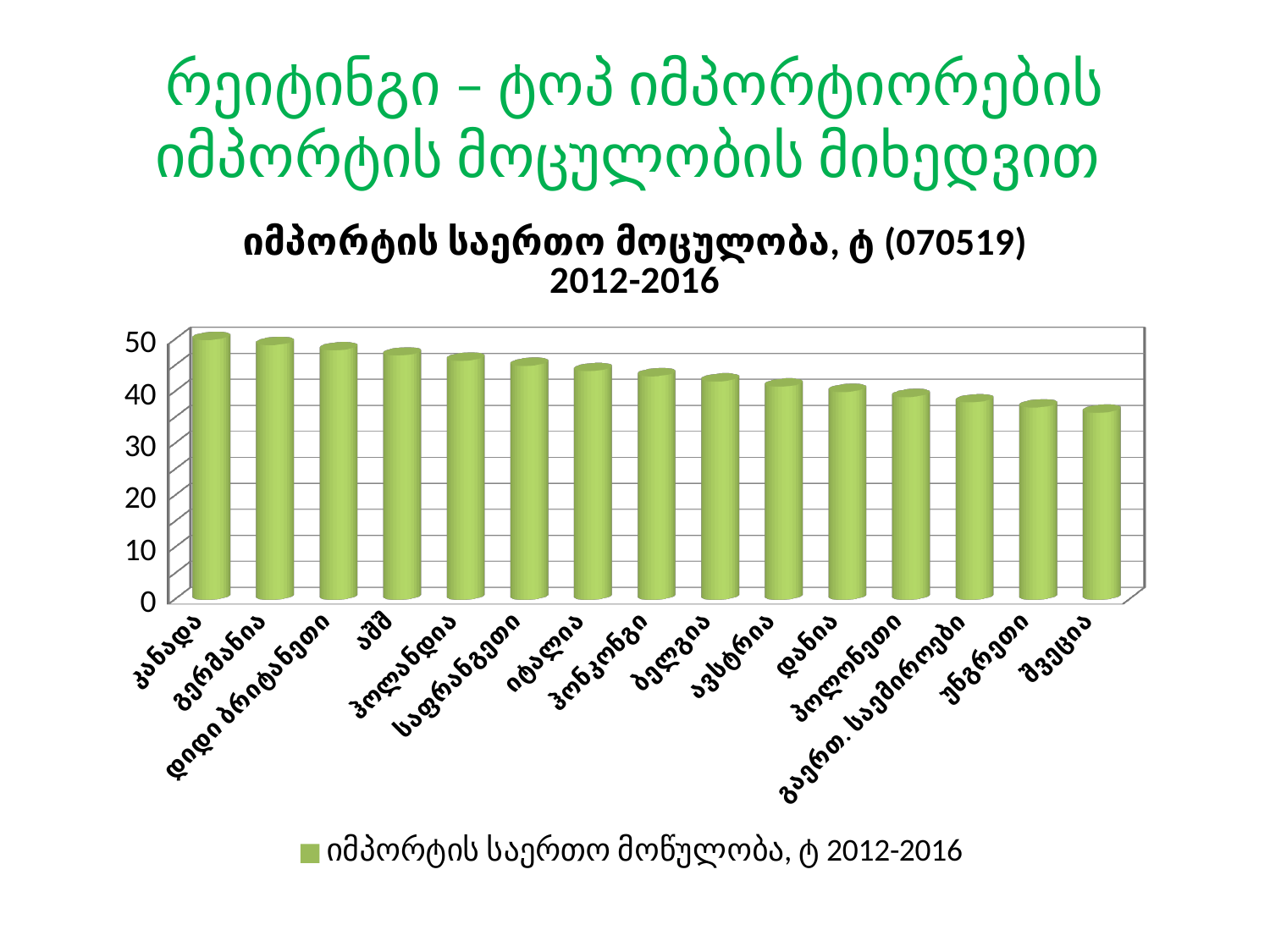
Do the bar values rise or fall from left to right along the x axis? fall Which has the larger value, გერმანია or უნგრეთი? გერმანია How many countries (bars) are shown in the chart? 15 What kind of chart is shown on the slide? bar chart What years does the chart title say the data covers? 2012-2016 Which country has the highest bar in the chart? კანადა Is the value for შვეცია greater or less than 40? less Is the value for ჰონკონგი greater or less than 40? greater How many series does the legend list? 1 Is the value for უნგრეთი greater or less than 40? less Which country has the lowest bar in the chart? შვეცია